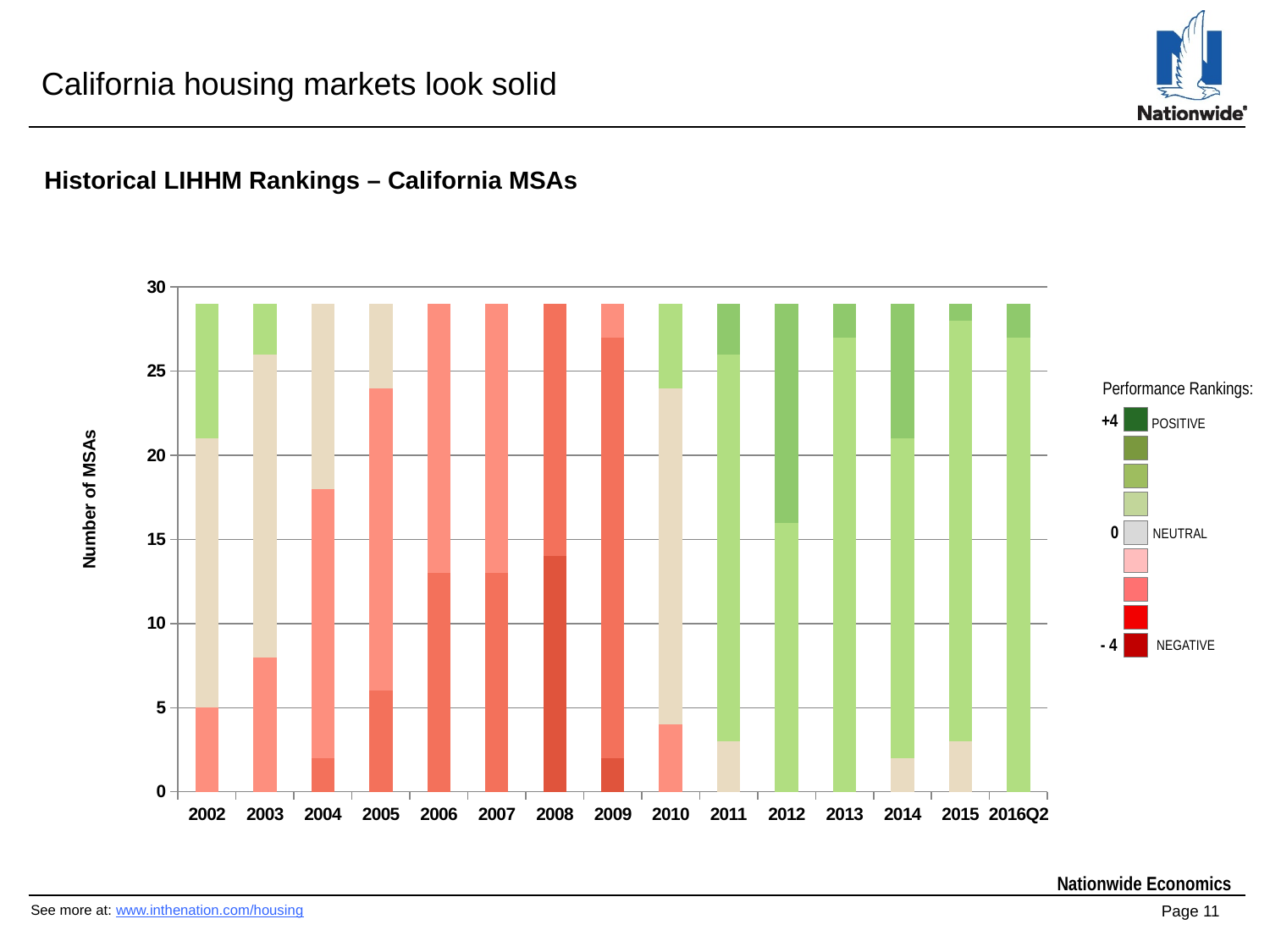
Is the top of the bottom (dark red) segment in the 2008 bar greater or less than 10? greater Is the top of the bottom (red) segment in the 2002 bar greater or less than 10? less Is the total bar height for 2016Q2 greater or less than 30? less What kind of chart is shown on the slide? Stacked bar chart What is the first year shown on the x axis of the chart? 2002 What is the label on the vertical axis of the chart? Number of MSAs Do the total bar heights rise, fall, or stay roughly the same from 2002 to 2016Q2? Stay roughly the same What is the title of the chart? Historical LIHHM Rankings – California MSAs How many years (categories) are shown along the x axis of the chart? 15